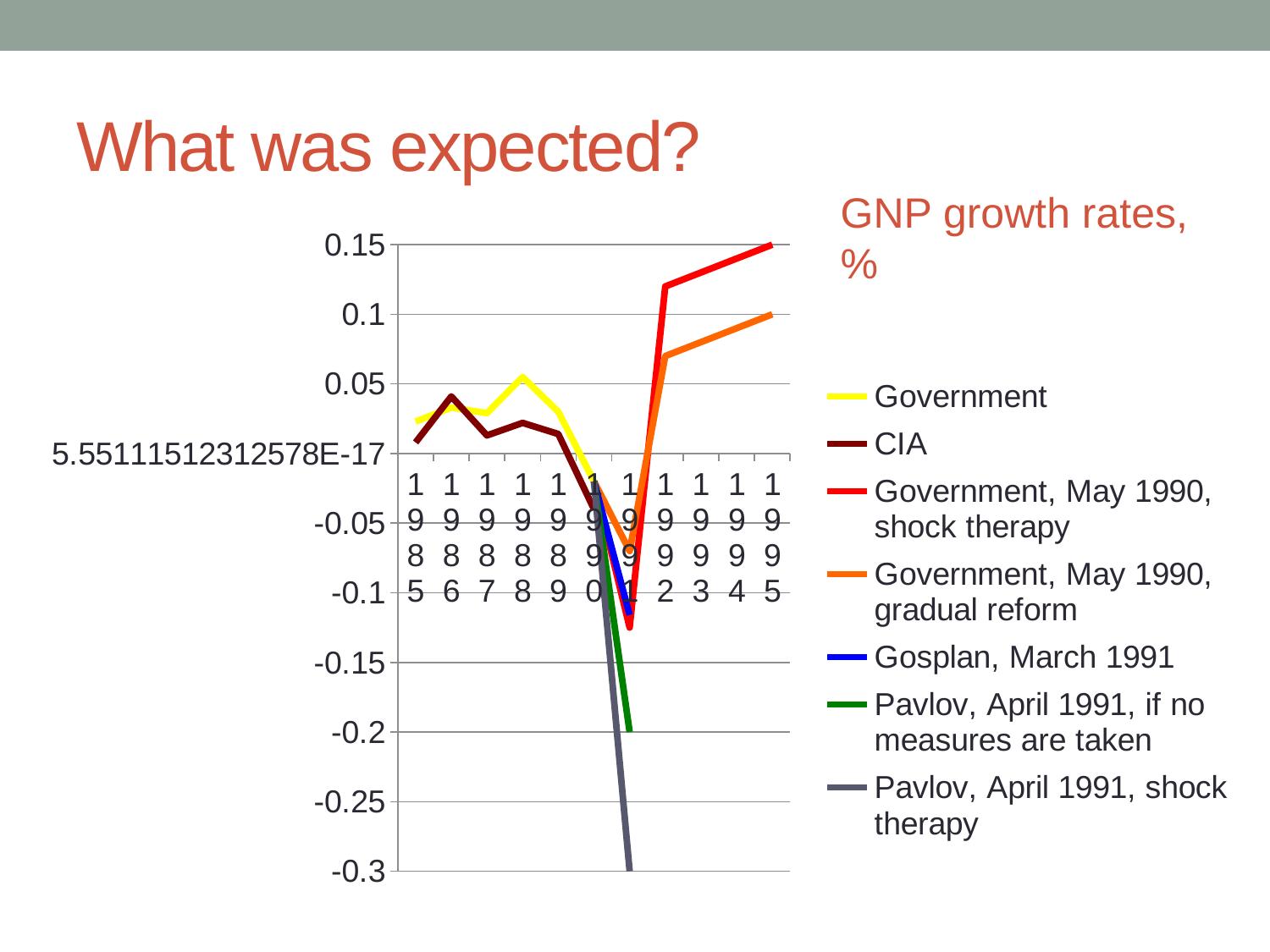
How many years are shown along the x axis of the chart? 11 What colour is the line for the Government series? yellow Which series reaches the lowest value on the chart? Pavlov, April 1991, shock therapy Is the lowest value of the Pavlov, April 1991, shock therapy series greater or less than -0.25? less Does the Government, May 1990, shock therapy series rise or fall from 1991 to 1995? rise Is the value for Government, May 1990, shock therapy in 1995 greater or less than 0.1? greater Which series reaches the highest value on the chart? Government, May 1990, shock therapy What is the title of the chart? GNP growth rates, % How many series does the legend of the chart list? 7 What kind of chart is shown on the slide? line chart Is the value for Government, May 1990, gradual reform in 1995 greater or less than 0.05? greater In 1995, which series is higher: Government, May 1990, shock therapy or Government, May 1990, gradual reform? Government, May 1990, shock therapy